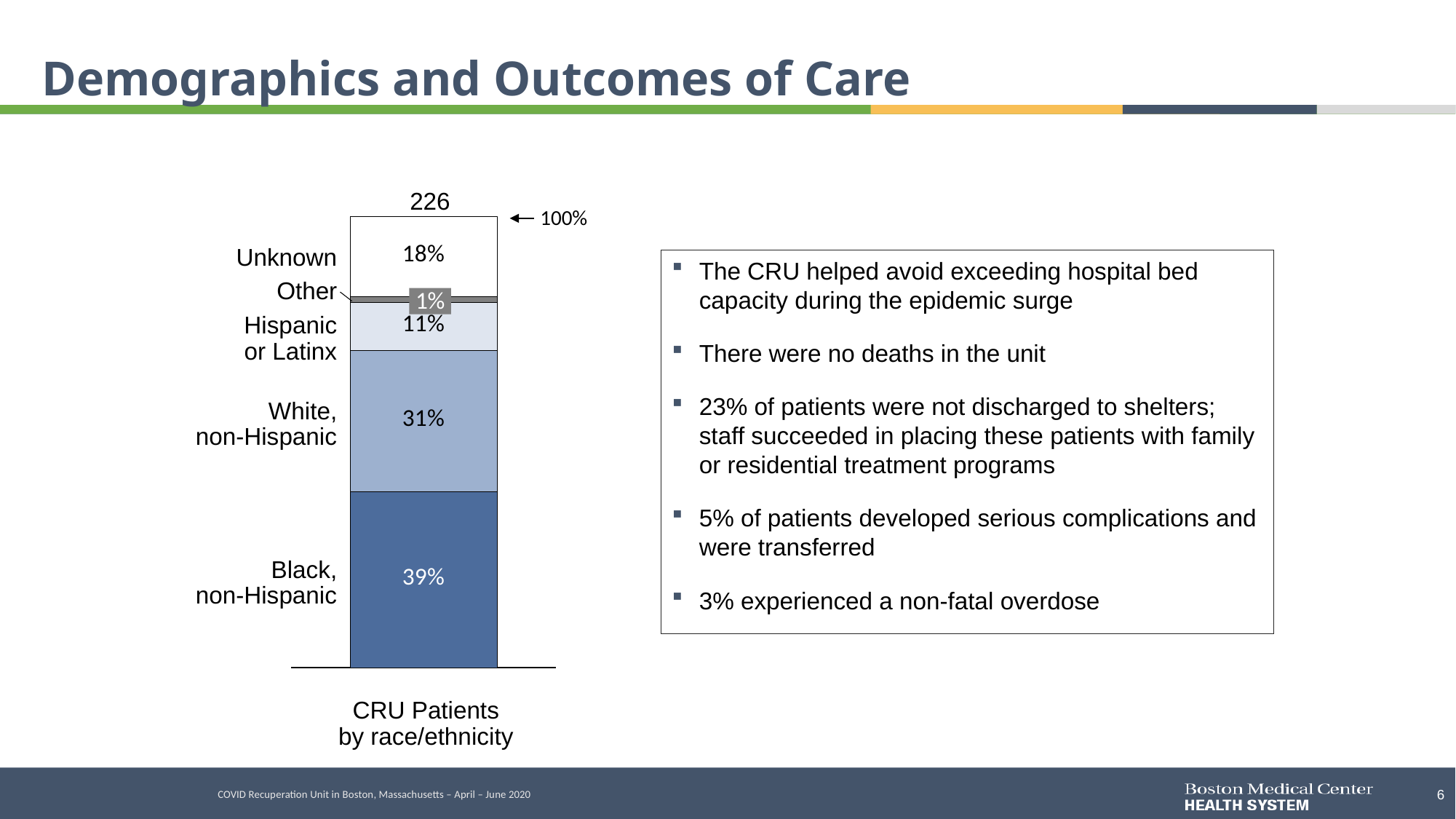
Which race/ethnicity category has the largest share of CRU patients? Black, non-Hispanic What percentage of CRU patients are in the Other category? 1% What is the difference in percentage points between Black, non-Hispanic and White, non-Hispanic patients? 8 Which race/ethnicity category has the smallest share of CRU patients? Other Which is larger, the share of Unknown patients or the share of Hispanic or Latinx patients? Unknown What total number of CRU patients is shown above the bar? 226 What percentage of CRU patients are Black, non-Hispanic? 39% What percentage of CRU patients have race/ethnicity listed as Unknown? 18% What percentage of CRU patients are White, non-Hispanic? 31% What type of chart is shown on the slide? Stacked bar chart What percentage of CRU patients are Hispanic or Latinx? 11% How many race/ethnicity categories are shown in the stacked bar? 5